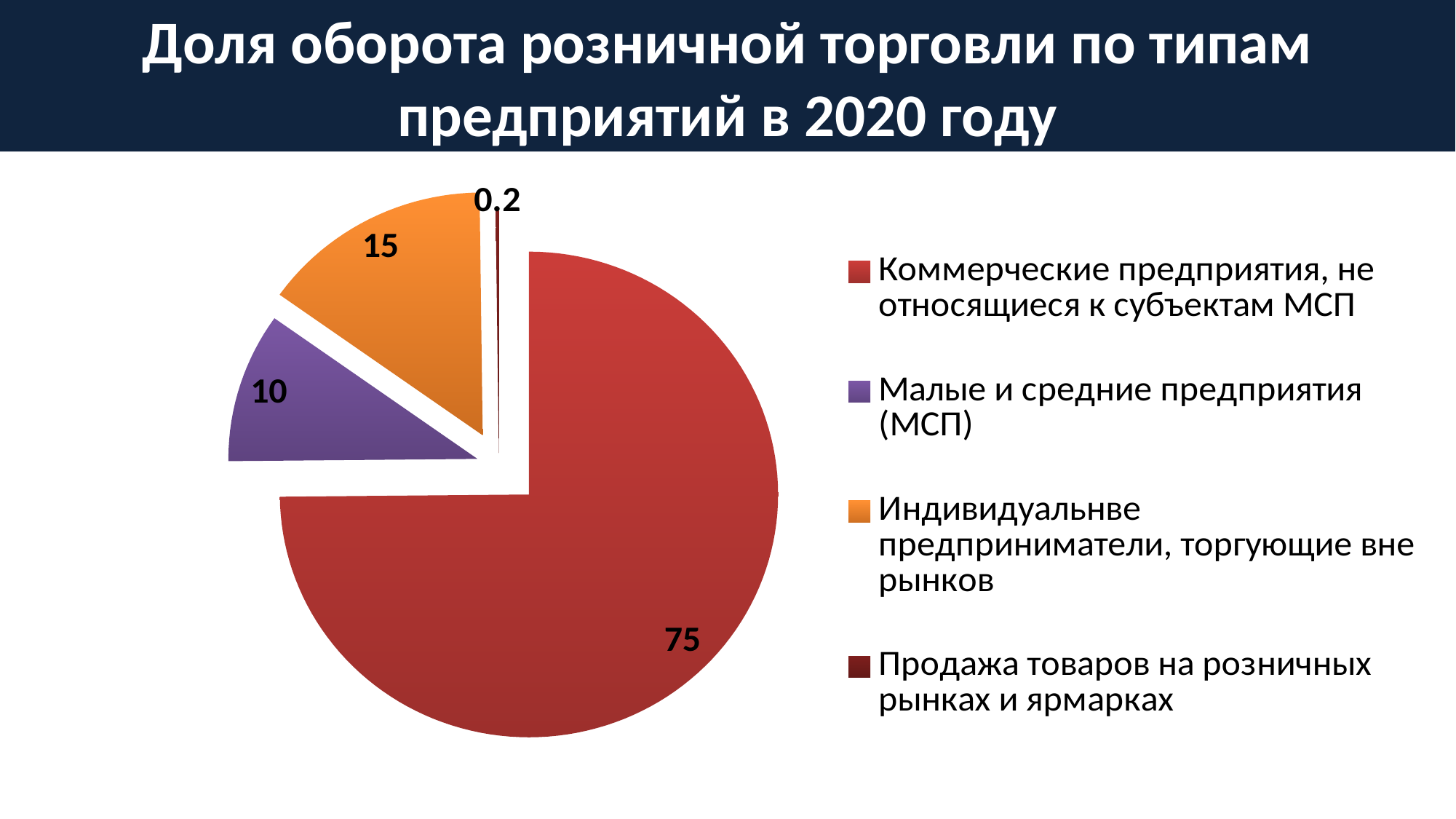
Which is larger: the value for "Малые и средние предприятия (МСП)" or the value for "Индивидуальнве предприниматели, торгующие вне рынков"? Индивидуальнве предприниматели, торгующие вне рынков What is the value for "Продажа товаров на розничных рынках и ярмарках"? 0.2 Which category has the largest slice of the pie? Коммерческие предприятия, не относящиеся к субъектам МСП What is the value for "Малые и средние предприятия (МСП)"? 10 What is the title of the chart? Доля оборота розничной торговли по типам предприятий в 2020 году What is the difference between the values for "Коммерческие предприятия, не относящиеся к субъектам МСП" and "Индивидуальнве предприниматели, торгующие вне рынков"? 60 What is the value for "Коммерческие предприятия, не относящиеся к субъектам МСП"? 75 How many categories does the pie chart have? 4 Which category has the smallest slice of the pie? Продажа товаров на розничных рынках и ярмарках What type of chart is shown on the slide? pie chart What is the value for "Индивидуальнве предприниматели, торгующие вне рынков"? 15 What is the difference between the values for "Индивидуальнве предприниматели, торгующие вне рынков" and "Малые и средние предприятия (МСП)"? 5